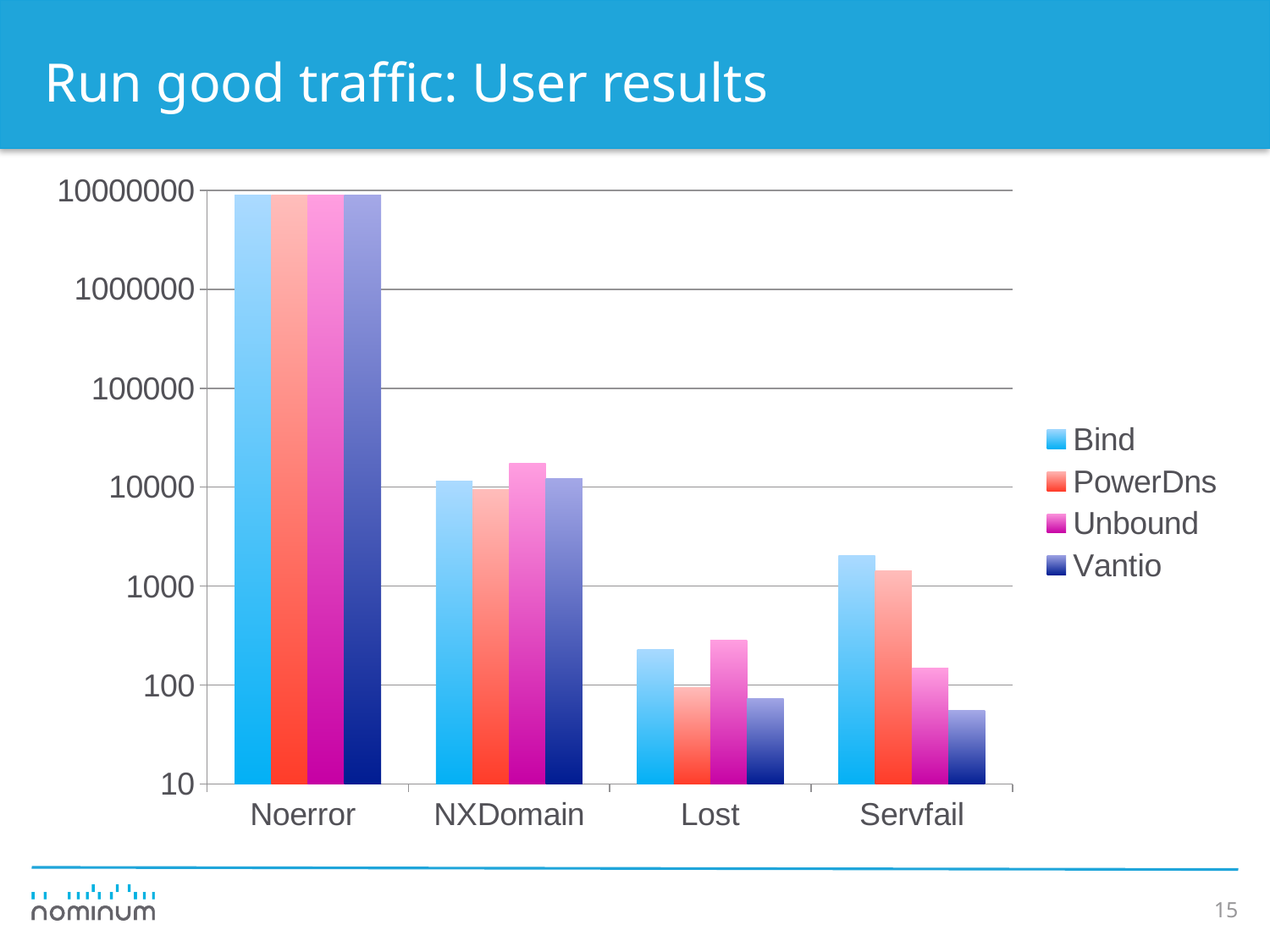
Is the value for Vantio in the Lost category greater or less than 100? less Which series has the highest value in the Servfail category? Bind Is the value for Bind in the Servfail category greater or less than 1000? greater In the Lost category, which is larger, Unbound or Vantio? Unbound What is the title of the slide? Run good traffic: User results Which series has the lowest value in the Lost category? Vantio How many categories are shown on the x axis? 4 How many series does the legend list? 4 Is the value for Unbound in the NXDomain category greater or less than 10000? greater Which series is shown in magenta in the legend? Unbound What kind of chart is shown on the slide? bar chart